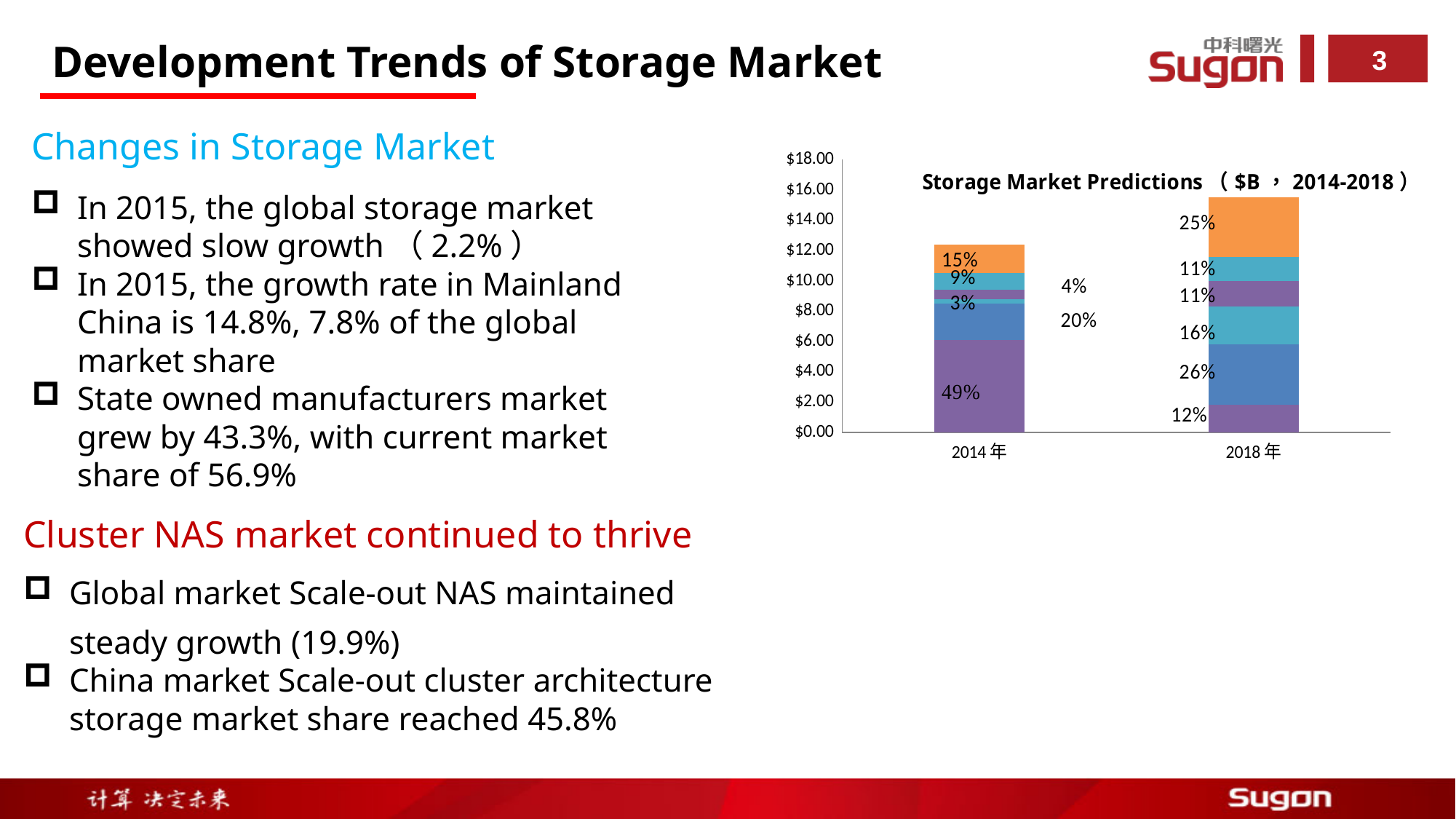
What kind of chart is shown on the slide? stacked bar chart What percentage label is shown on the top (orange) segment of the 2018年 bar? 25% What percentage label is shown on the top (orange) segment of the 2014年 bar? 15% Is the total height of the 2018年 bar greater or less than $14.00? greater What percentage label is shown on the bottom segment of the 2018年 bar? 12% Is the total height of the 2014年 bar greater or less than $10.00? greater Which percentage label is the largest within the 2018年 bar? 26% How many years (categories) are plotted on the x axis of the chart? 2 What is the title of the chart? Storage Market Predictions ($B, 2014-2018) Which year has the taller stacked bar, 2014年 or 2018年? 2018年 What percentage label is shown on the bottom (purple) segment of the 2014年 bar? 49% Does the total storage market value rise or fall from 2014年 to 2018年? rise